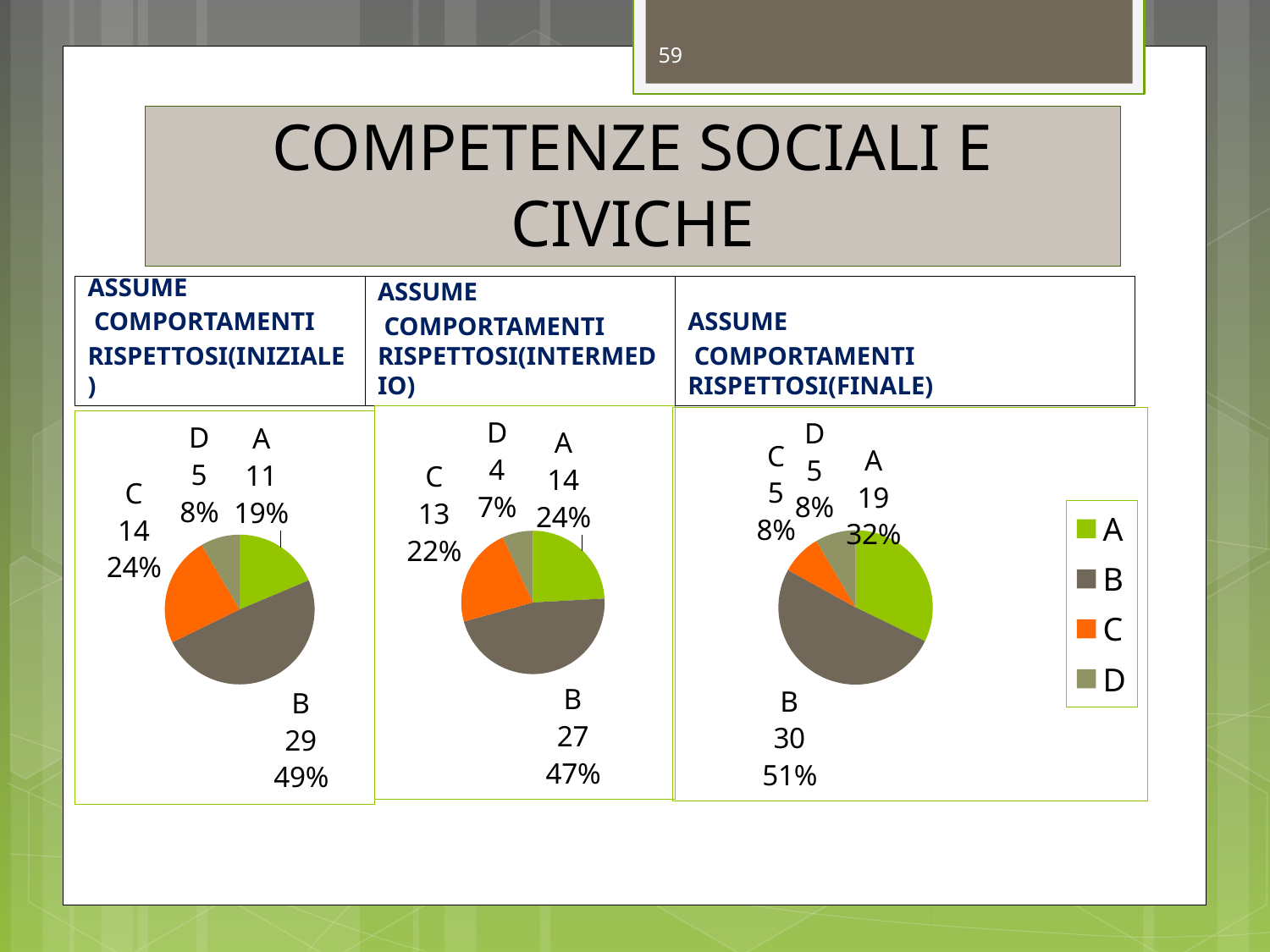
In the FINALE pie chart (right), what percentage share does category B have? 51% In the FINALE pie chart (right), what is the value for category A? 19 In the FINALE pie chart (right), which category has the largest slice? B In the INIZIALE pie chart (left), what is the difference between the values for B and A? 18 In the INTERMEDIO pie chart (middle), what percentage share does category D have? 7% In the INIZIALE pie chart (left), what is the value for category B? 29 In the INTERMEDIO pie chart (middle), what is the value for category A? 14 How many categories does the legend on the right of the slide list? 4 In the INIZIALE pie chart (left), what percentage share does category C have? 24% What kind of chart is used in the INIZIALE chart (left)? Pie chart In the INTERMEDIO pie chart (middle), which category has the smallest slice? D In the FINALE pie chart (right), which is larger, the value for A or the value for C? A